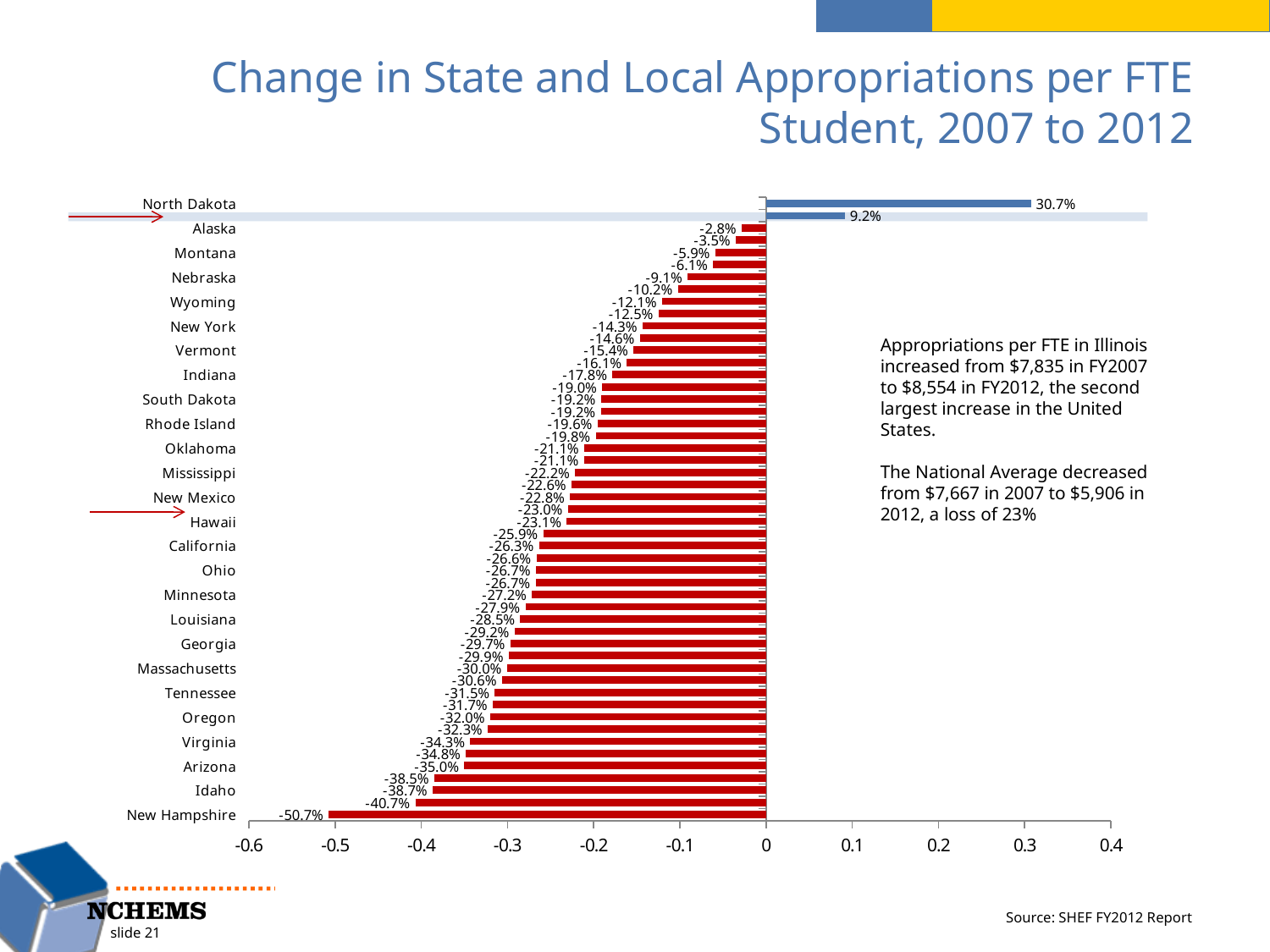
What type of chart is shown on the slide? bar chart What is the value for New Hampshire? -50.7% What is the value for North Dakota? 30.7% What is the value for Montana? -5.9% What is the title of the chart? Change in State and Local Appropriations per FTE Student, 2007 to 2012 Which is larger, the value for Alaska or the value for Montana? Alaska What is the value for Alaska? -2.8% How many bars are plotted in the chart? 51 Which state has the highest value? North Dakota Which state has the lowest value? New Hampshire What is the difference between the values for North Dakota and New Hampshire? 81.4 percentage points Is the value for New Hampshire greater or less than -0.5? less